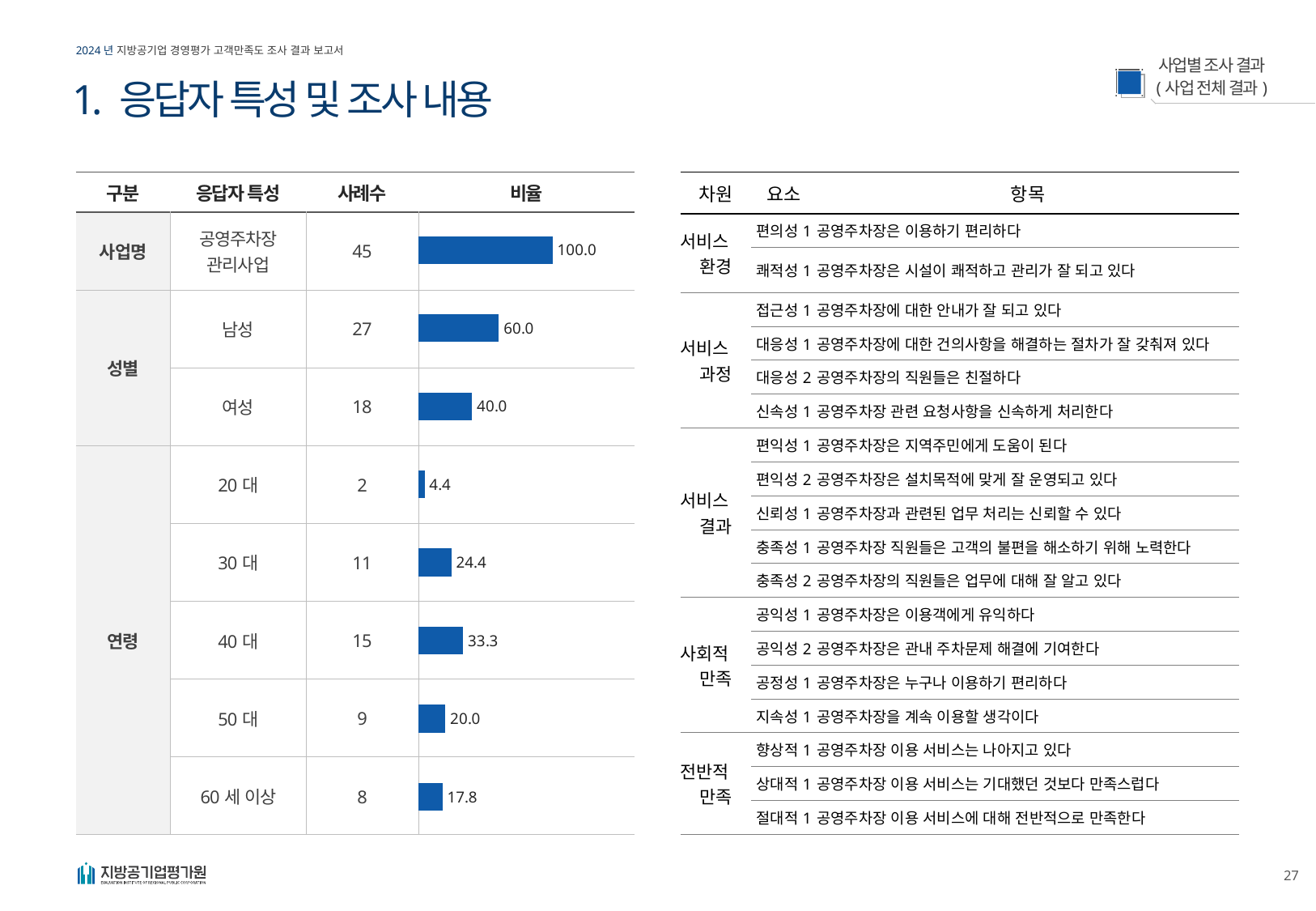
What is the 비율 value shown for 40 대? 33.3 What is the 사례수 (number of cases) for 30 대? 11 How many bars are shown in the 비율 column of the left table? 8 What is the difference between the 비율 values for 40 대 and 30 대? 8.9 What is the 비율 value shown for 남성? 60.0 Which age group (연령) has the highest 비율 bar? 40 대 What is the 비율 value shown for 여성? 40.0 Which age group (연령) has the lowest 비율 bar? 20 대 What type of chart is used in the 비율 column of the left table? bar chart Which has a larger 비율 value, 30 대 or 50 대? 30 대 What is the difference between the 비율 values for 남성 and 여성? 20.0 What is the 비율 value shown for 60 세 이상? 17.8